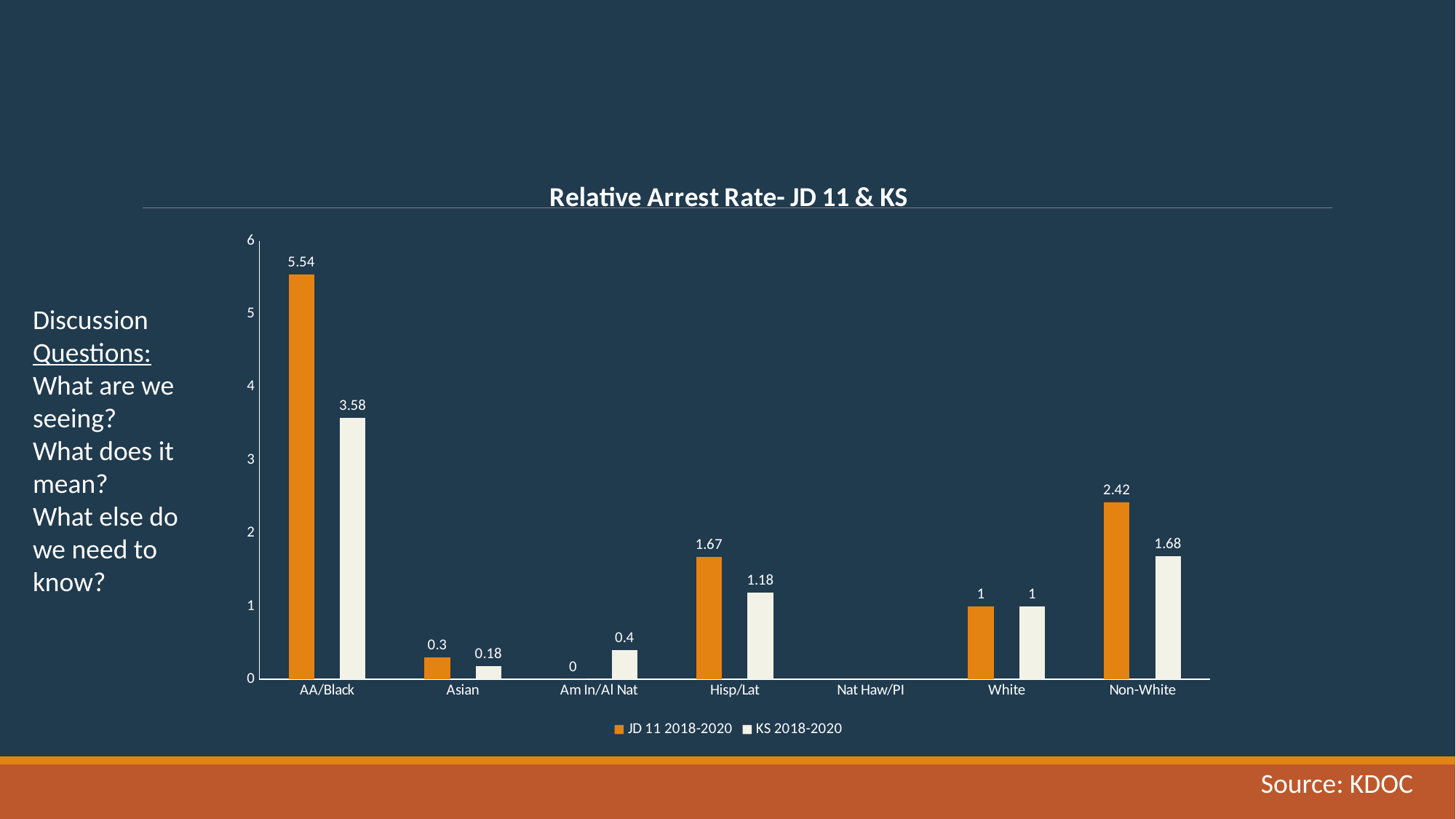
What type of chart is shown on the slide? Bar chart Which is larger for Asian: the JD 11 2018-2020 value or the KS 2018-2020 value? JD 11 2018-2020 What is the difference between the JD 11 2018-2020 and KS 2018-2020 values for AA/Black? 1.96 How many series does the legend list? 2 What is the KS 2018-2020 value for Hisp/Lat? 1.18 Which category has the lowest KS 2018-2020 value among those with a labelled bar? Asian Is the JD 11 2018-2020 value for Non-White greater or less than 2? greater How many categories are shown on the x axis? 7 What is the difference between the JD 11 2018-2020 and KS 2018-2020 values for Non-White? 0.74 Which category has the highest JD 11 2018-2020 value? AA/Black What is the JD 11 2018-2020 value for AA/Black? 5.54 What is the KS 2018-2020 value for Am In/Al Nat? 0.4